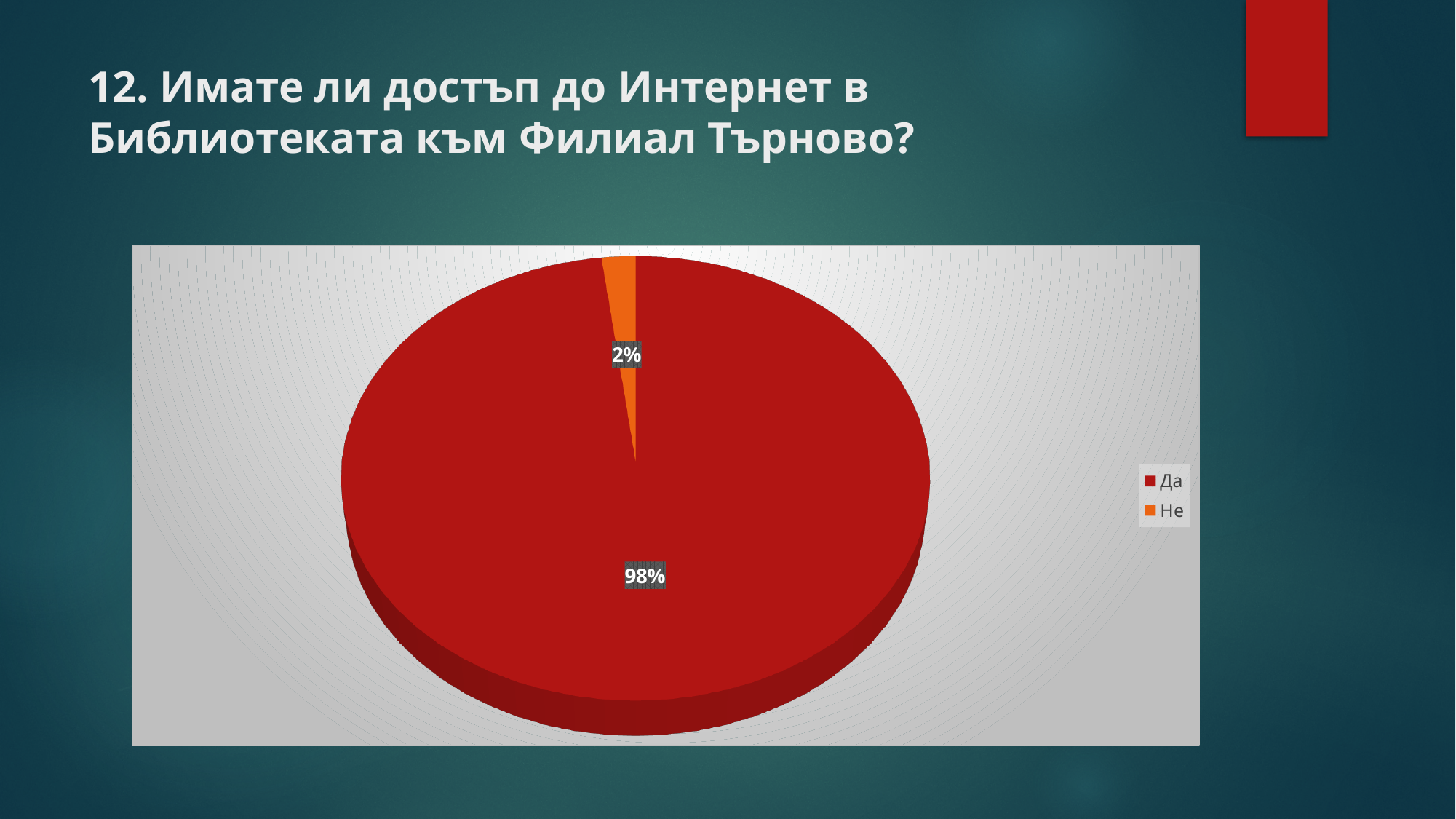
What share of the pie does the "Не" slice represent? 2% Which category has the smallest share of the pie chart? Не How many categories does the pie chart show? 2 How many entries does the legend list? 2 What percentage of the pie chart is labelled "Не"? 2% What kind of chart is shown on the slide? Pie chart What percentage of the pie chart is labelled "Да"? 98% What is the difference in percentage points between the "Да" and "Не" slices? 96 What colour is the "Да" slice in the pie chart? Red Which category has the largest share of the pie chart? Да What colour is the "Не" slice in the pie chart? Orange Which slice is larger, "Да" or "Не"? Да